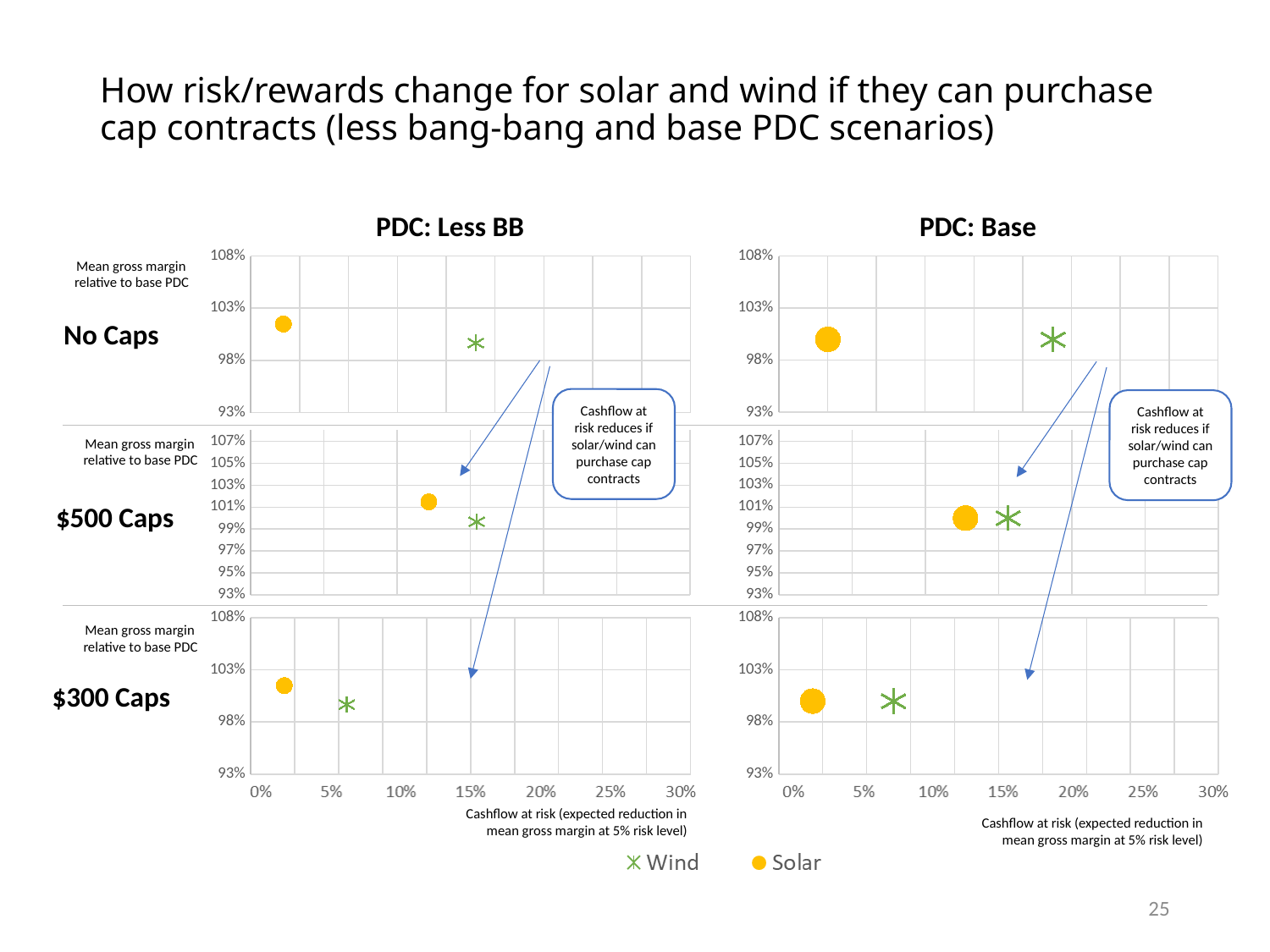
In the PDC: Less BB $300 Caps chart, which series has the higher mean gross margin relative to base PDC, Wind or Solar? Solar How many series does the legend at the bottom of the slide list? 2 In the PDC: Less BB No Caps chart, which series has the higher cashflow at risk, Wind or Solar? Wind In the PDC: Base $300 Caps chart, is the cashflow at risk for Solar greater or less than 5%? less In the PDC: Less BB No Caps chart, is the cashflow at risk for Solar greater or less than 5%? less What is the title of the chart column on the right side of the slide? PDC: Base Which two series are listed in the legend? Wind and Solar In the PDC: Base $300 Caps chart, is the cashflow at risk for Wind greater or less than 10%? less What kind of chart is the PDC: Less BB No Caps chart? scatter chart How many data points are plotted in the PDC: Base $500 Caps chart? 2